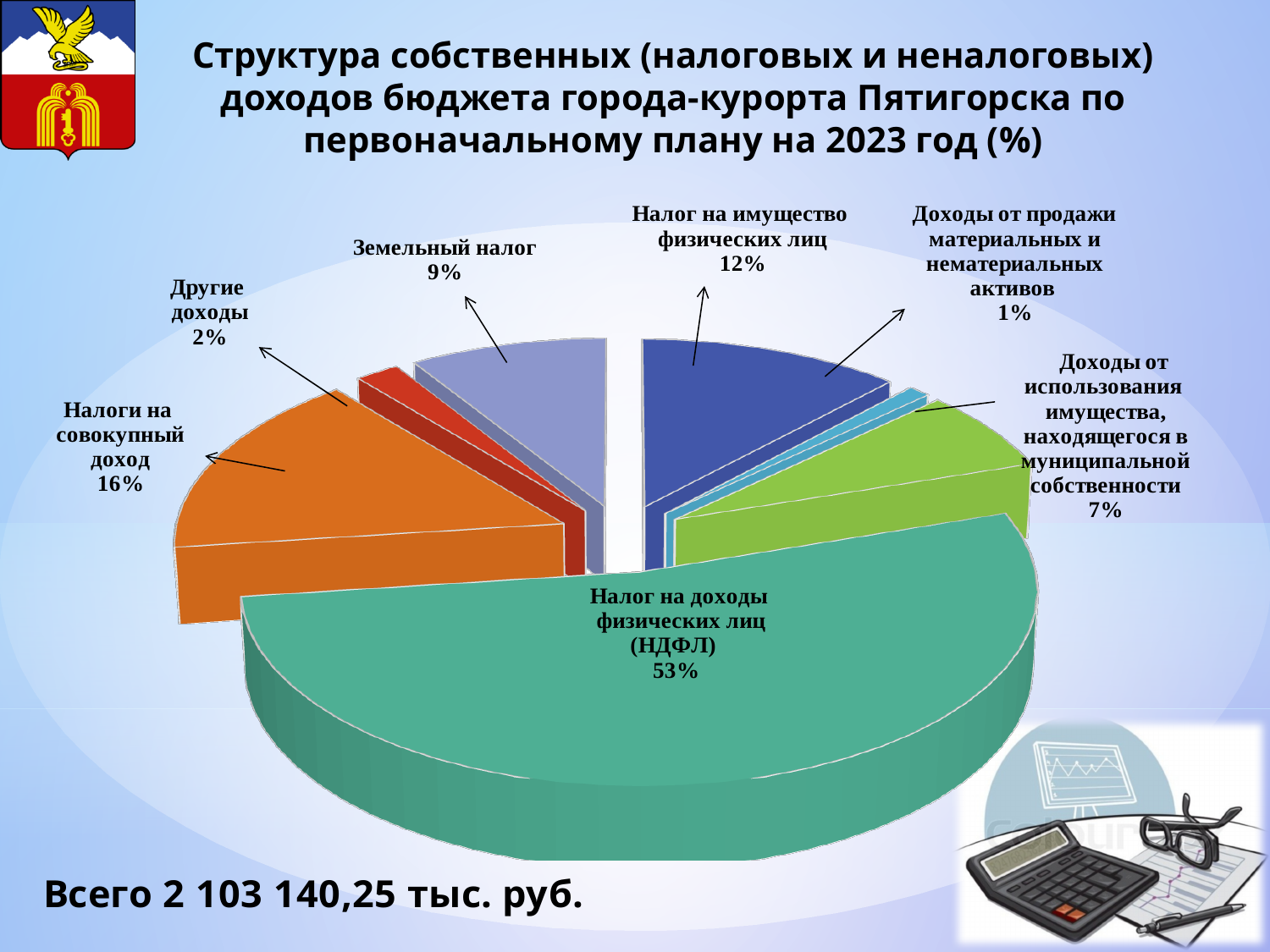
Which category has the largest share of the pie? Налог на доходы физических лиц (НДФЛ) What share of the budget's own revenues does Налог на доходы физических лиц (НДФЛ) account for? 53% What total amount of own revenues is stated on the slide? 2 103 140,25 тыс. руб. Which category has the smallest share of the pie? Доходы от продажи материальных и нематериальных активов What is the difference in percentage points between Налоги на совокупный доход and Налог на имущество физических лиц? 4 What percentage is shown for Земельный налог? 9% What percentage is shown for Доходы от использования имущества, находящегося в муниципальной собственности? 7% For which year does the chart show the planned structure of own revenues? 2023 What type of chart is shown on the slide? Pie chart Which is larger: the share of Земельный налог or the share of Другие доходы? Земельный налог How many categories (slices) does the pie chart have? 7 What percentage is shown for Налоги на совокупный доход? 16%